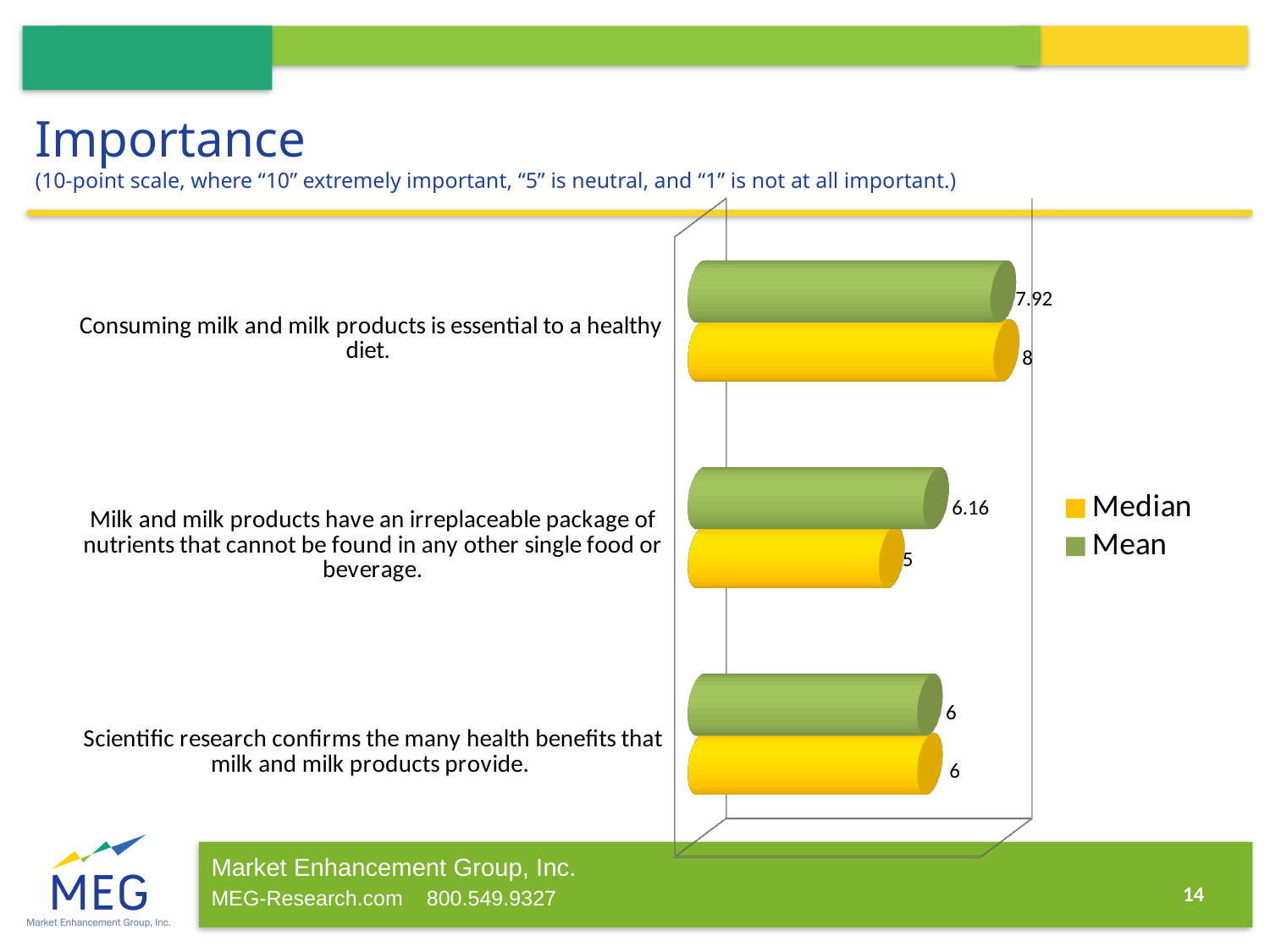
What is the difference between the Mean and Median values for "Milk and milk products have an irreplaceable package of nutrients that cannot be found in any other single food or beverage"? 1.16 What is the Mean value for "Scientific research confirms the many health benefits that milk and milk products provide"? 6 What kind of chart is shown on the slide? Bar chart What is the Mean value for "Consuming milk and milk products is essential to a healthy diet"? 7.92 What is the Median value for "Milk and milk products have an irreplaceable package of nutrients that cannot be found in any other single food or beverage"? 5 Which statement has the highest Mean value? Consuming milk and milk products is essential to a healthy diet. What is the Mean value for "Milk and milk products have an irreplaceable package of nutrients that cannot be found in any other single food or beverage"? 6.16 How many statements (categories) are shown in the chart? 3 What is the Median value for "Consuming milk and milk products is essential to a healthy diet"? 8 How many series does the legend list? 2 For "Consuming milk and milk products is essential to a healthy diet", which is larger, the Mean or the Median? Median Which statement has the lowest Median value? Milk and milk products have an irreplaceable package of nutrients that cannot be found in any other single food or beverage.